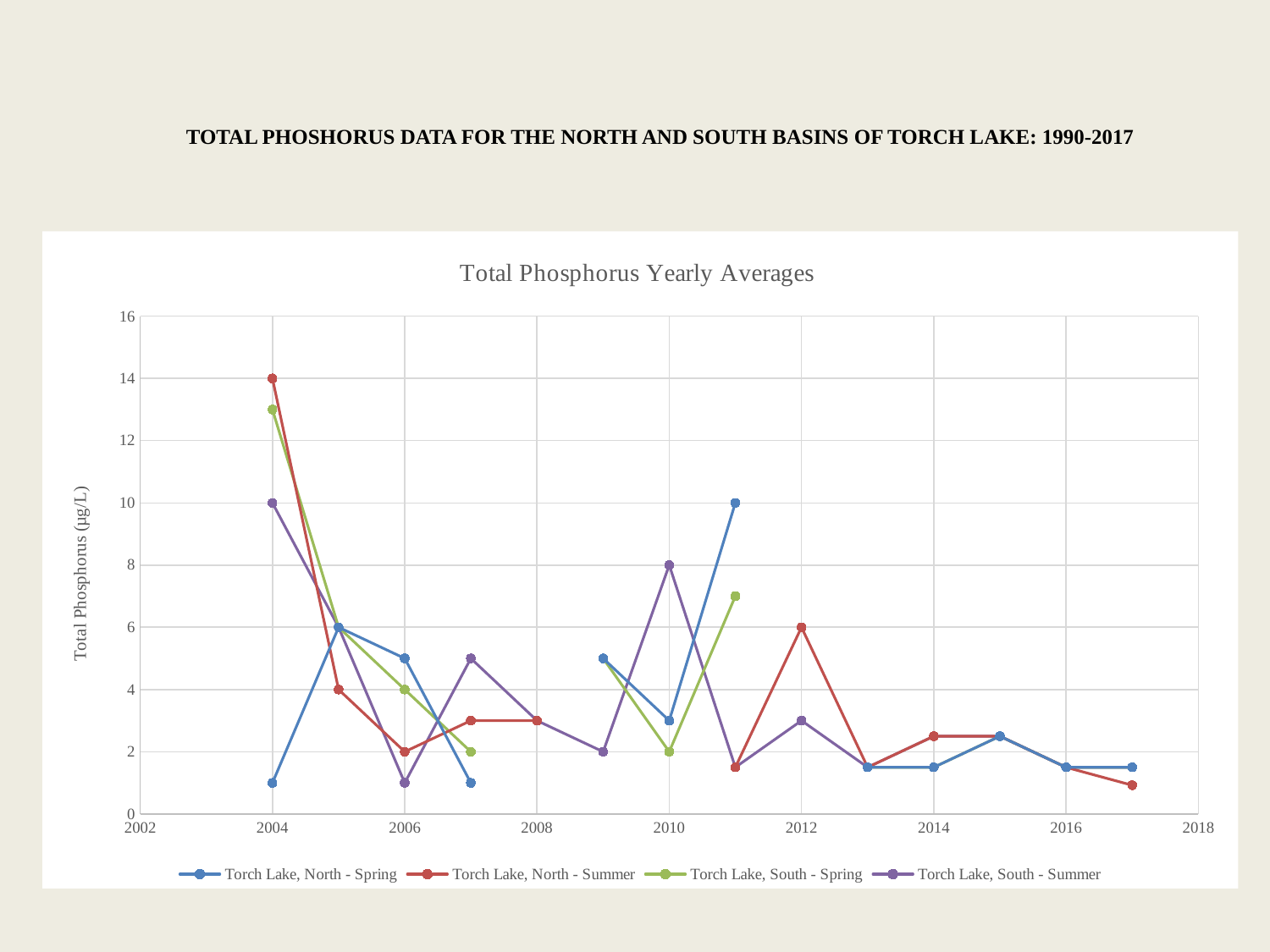
How many series does the legend list? 4 What is the value for Torch Lake, North - Spring in 2011? 10 What is the title of the chart? Total Phosphorus Yearly Averages Does the Torch Lake, North - Summer series rise or fall from 2004 to 2006? fall What is the value for Torch Lake, North - Summer in 2012? 6 What is the value for Torch Lake, North - Summer in 2004? 14 Is the value for Torch Lake, South - Spring in 2004 greater or less than 12? greater Which series has the highest value in 2004? Torch Lake, North - Summer What is the label of the vertical axis? Total Phosphorus (µg/L) What kind of chart is shown on the slide? line chart Which is larger in 2010: Torch Lake, South - Summer or Torch Lake, North - Spring? Torch Lake, South - Summer What is the value for Torch Lake, South - Summer in 2010? 8